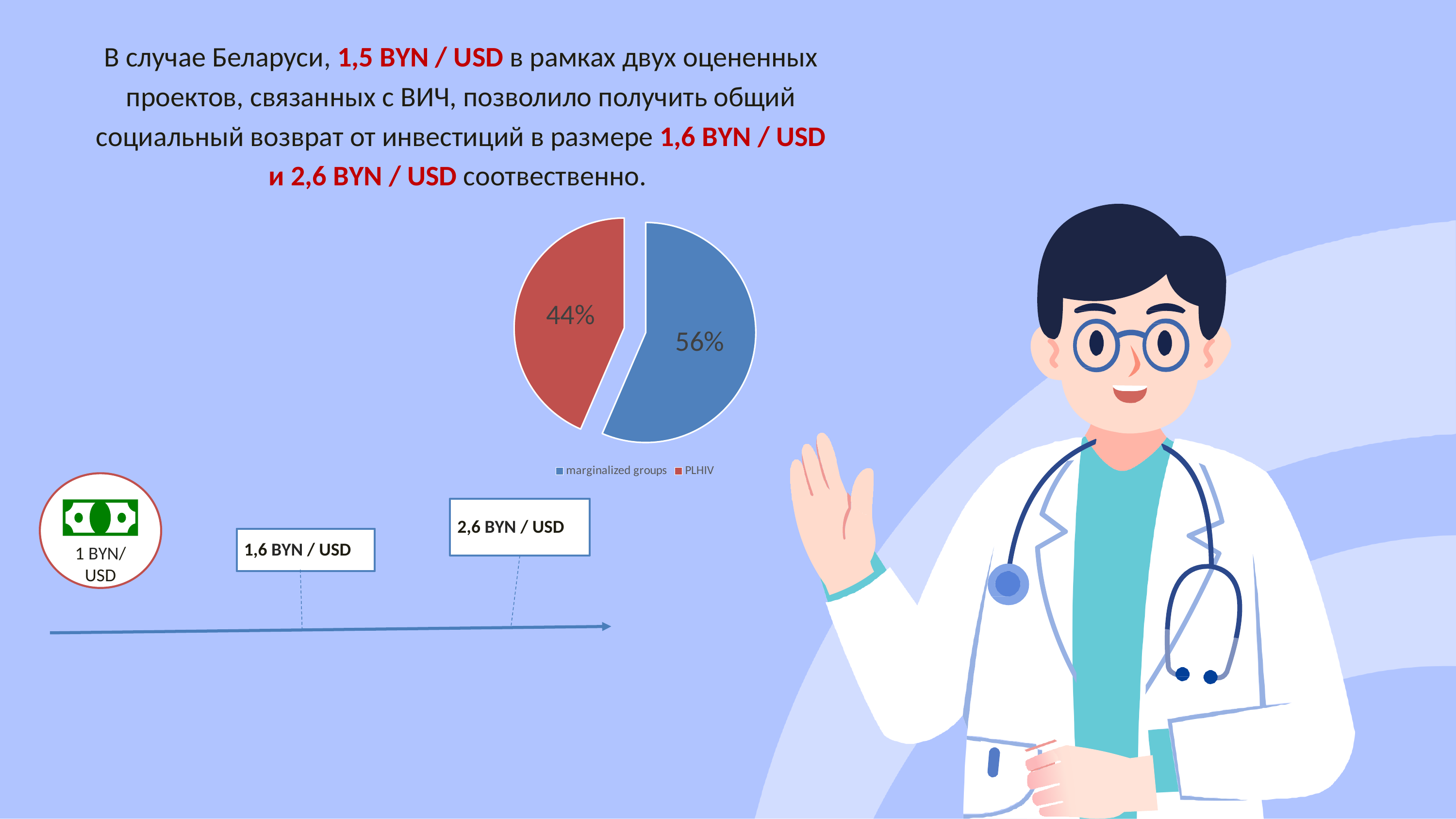
How many entries does the legend of the pie chart list? 2 What share of the pie does PLHIV have? 44% What colour is the PLHIV slice in the pie chart? red What is the difference in percentage points between the marginalized groups slice and the PLHIV slice? 12 Which slice of the pie is the smallest? PLHIV What colour is the marginalized groups slice in the pie chart? blue Which is larger, the marginalized groups slice or the PLHIV slice? marginalized groups How many slices does the pie chart have? 2 Which slice of the pie is the largest? marginalized groups What kind of chart is shown on the slide? pie chart What share of the pie does marginalized groups have? 56%